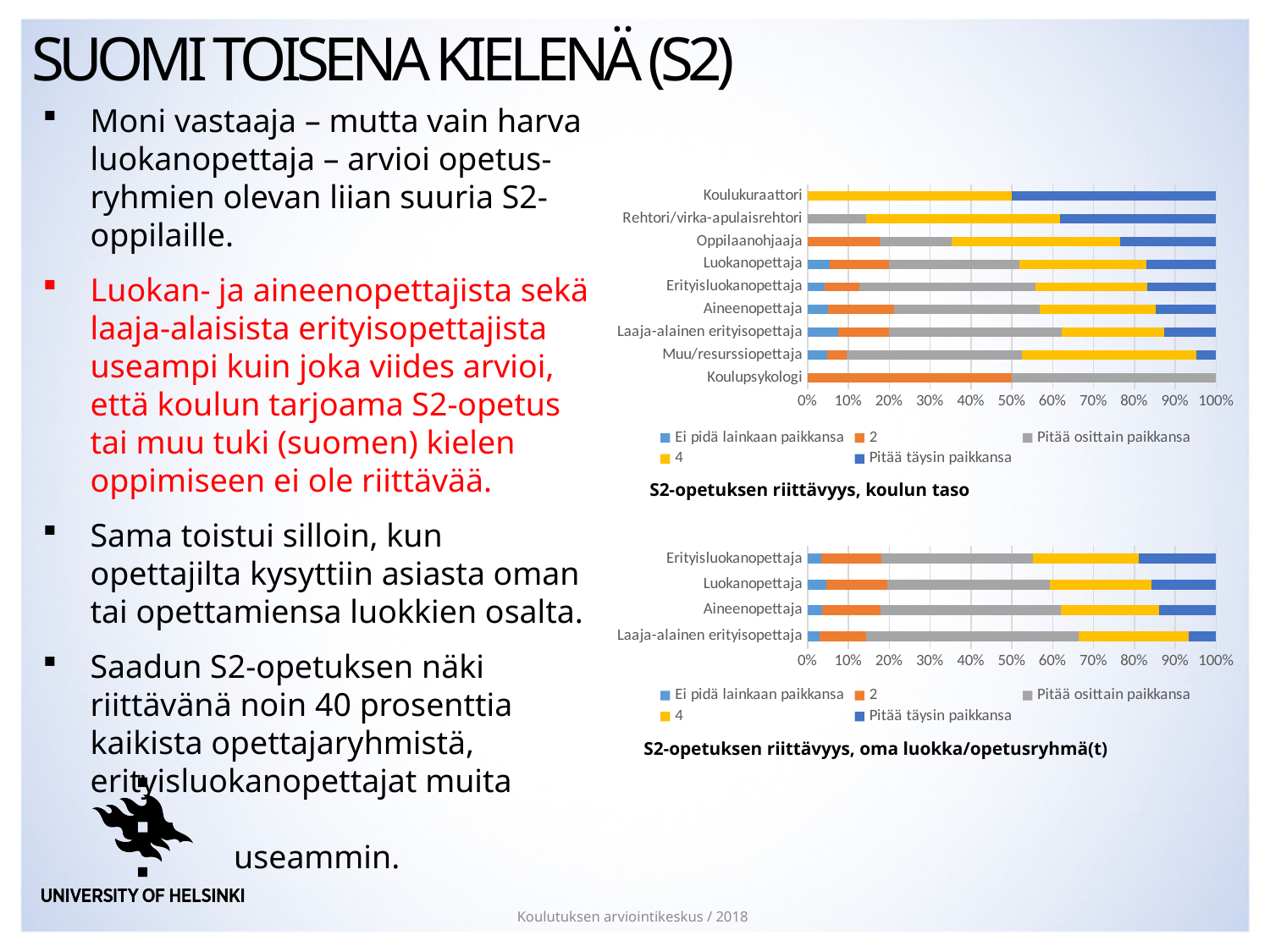
In the chart titled 'S2-opetuksen riittävyys, koulun taso', which category has the largest 'Pitää täysin paikkansa' share? Koulukuraattori How many categories are shown on the y axis of the chart titled 'S2-opetuksen riittävyys, oma luokka/opetusryhmä(t)'? 4 How many series does the legend list in the chart titled 'S2-opetuksen riittävyys, koulun taso'? 5 In the chart titled 'S2-opetuksen riittävyys, oma luokka/opetusryhmä(t)', is the 'Pitää täysin paikkansa' share for Laaja-alainen erityisopettaja greater or less than 10%? less In the chart titled 'S2-opetuksen riittävyys, koulun taso', is the 'Pitää osittain paikkansa' share for Koulupsykologi greater or less than 40%? greater What is the title of the lower chart on the slide? S2-opetuksen riittävyys, oma luokka/opetusryhmä(t) In the chart titled 'S2-opetuksen riittävyys, koulun taso', which has the larger 'Pitää täysin paikkansa' share: Koulukuraattori or Koulupsykologi? Koulukuraattori How many categories are shown on the y axis of the chart titled 'S2-opetuksen riittävyys, koulun taso'? 9 What kind of chart is the chart titled 'S2-opetuksen riittävyys, koulun taso'? Stacked bar chart In the chart titled 'S2-opetuksen riittävyys, koulun taso', is the 'Pitää täysin paikkansa' share for Koulukuraattori greater or less than 40%? greater In the chart titled 'S2-opetuksen riittävyys, koulun taso', which legend entry is shown in grey? Pitää osittain paikkansa